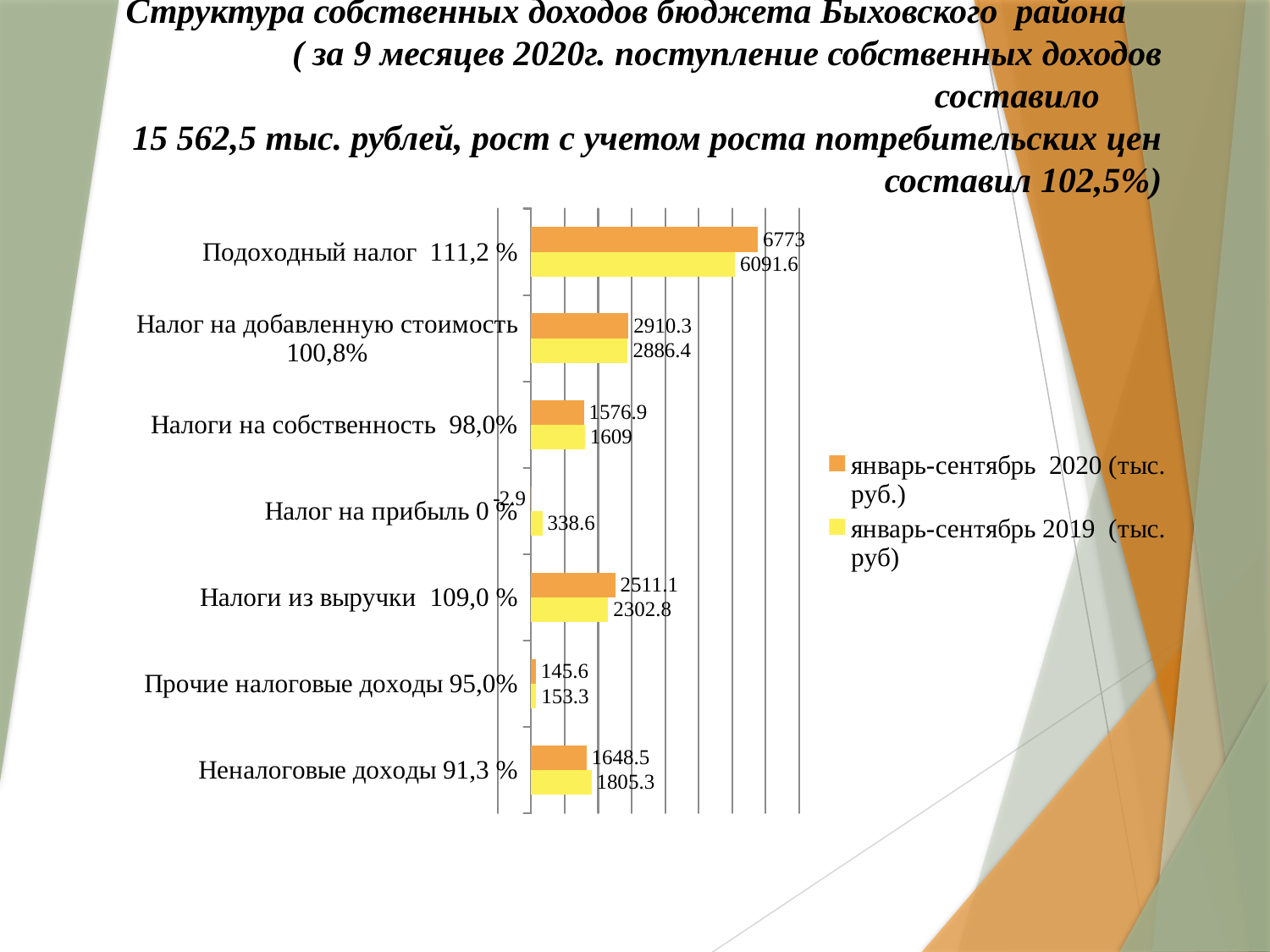
What is the value for Налог на прибыль in the январь-сентябрь 2019 (тыс. руб) series? 338.6 What is the difference between the 2019 and 2020 values for Неналоговые доходы? 156.8 Which category has the lowest value in the январь-сентябрь 2019 (тыс. руб) series? Прочие налоговые доходы What is the value for Прочие налоговые доходы in the январь-сентябрь 2020 (тыс. руб.) series? 145.6 What is the value for Неналоговые доходы in the январь-сентябрь 2019 (тыс. руб) series? 1805.3 What is the value for Подоходный налог in the январь-сентябрь 2020 (тыс. руб.) series? 6773 For Налоги из выручки, which series has the larger value: январь-сентябрь 2020 or январь-сентябрь 2019? январь-сентябрь 2020 What kind of chart is shown on the slide? Bar chart How many series does the legend list? 2 What is the difference between the 2020 and 2019 values for Подоходный налог? 681.4 How many categories are shown on the chart? 7 Which category has the highest value in the январь-сентябрь 2020 (тыс. руб.) series? Подоходный налог